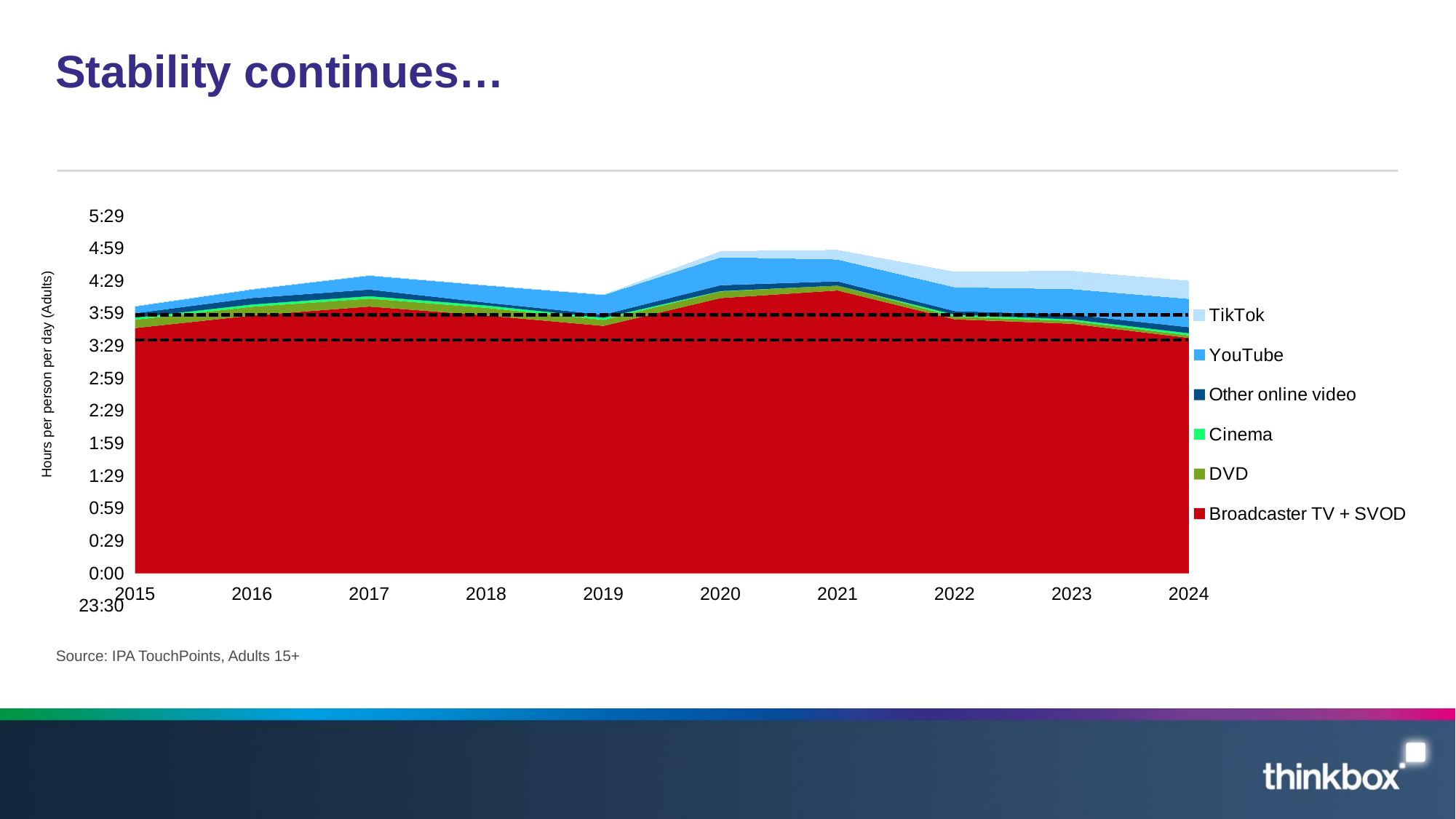
What is the title of the slide containing the chart? Stability continues… Is the value for Broadcaster TV + SVOD in 2021 greater or less than 3:59? greater Is the value for Broadcaster TV + SVOD in 2024 greater or less than 3:59? less Is the total of all series in 2021 greater or less than 4:29? greater How many years are shown on the x axis of the chart? 10 What kind of chart is shown on the slide? Stacked area chart What is the label on the chart's y axis? Hours per person per day (Adults) In which year is the Broadcaster TV + SVOD value lowest? 2024 Which series accounts for the largest share of the stacked area in every year? Broadcaster TV + SVOD How many series does the chart's legend list? 6 Does the Broadcaster TV + SVOD value rise or fall from 2021 to 2024? Fall